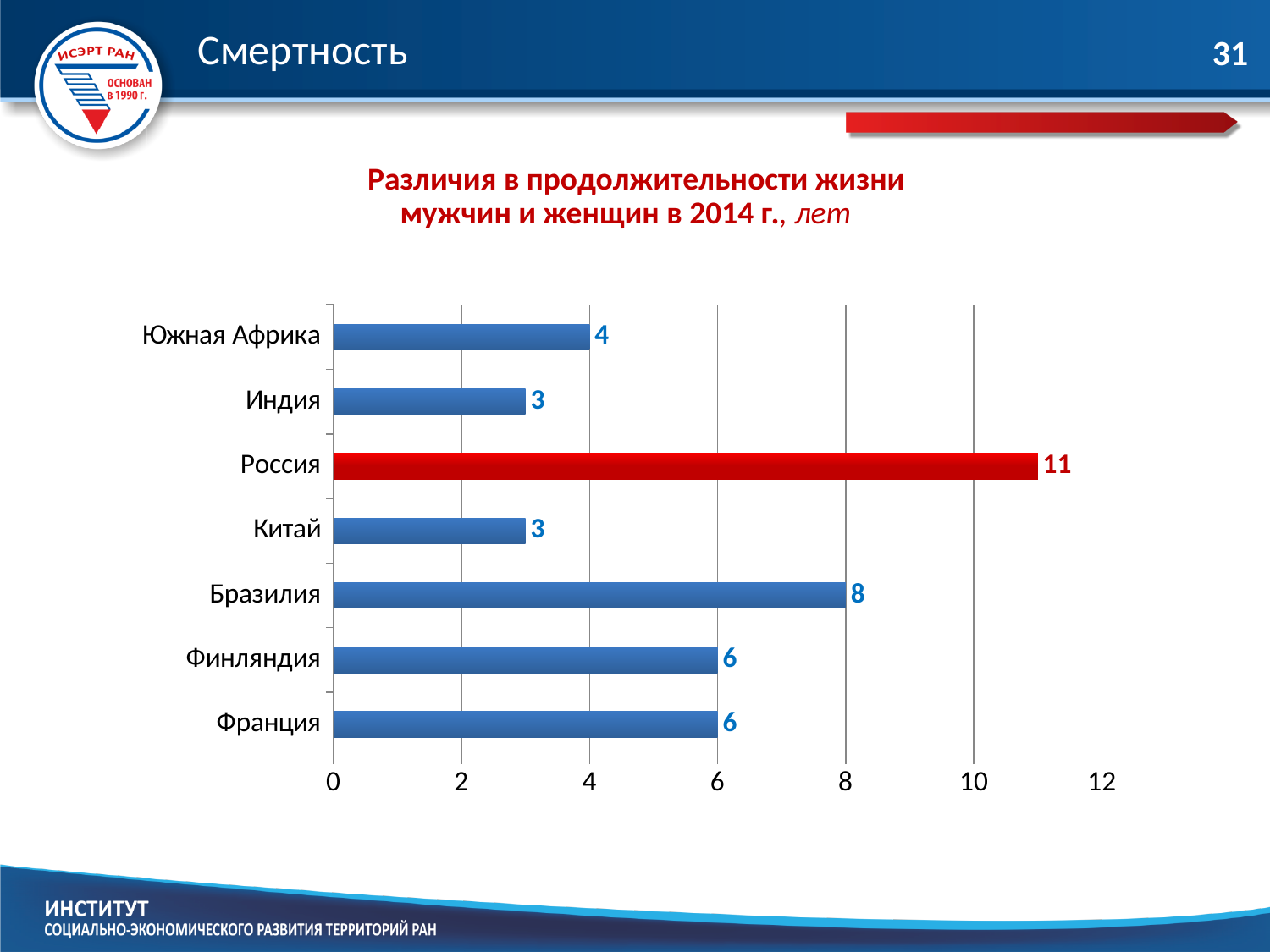
How many countries are shown in the chart? 7 What is the value for Финляндия? 6 What kind of chart is shown on the slide? bar chart What is the value for Бразилия? 8 What is the difference between the values for Южная Африка and Индия? 1 What is the value for Россия? 11 Which country's bar is coloured red? Россия What is the value for Южная Африка? 4 Which country has the highest value? Россия Is the value for Россия greater or less than 10? greater Which is larger, the value for Бразилия or the value for Франция? Бразилия What is the difference between the values for Россия and Бразилия? 3